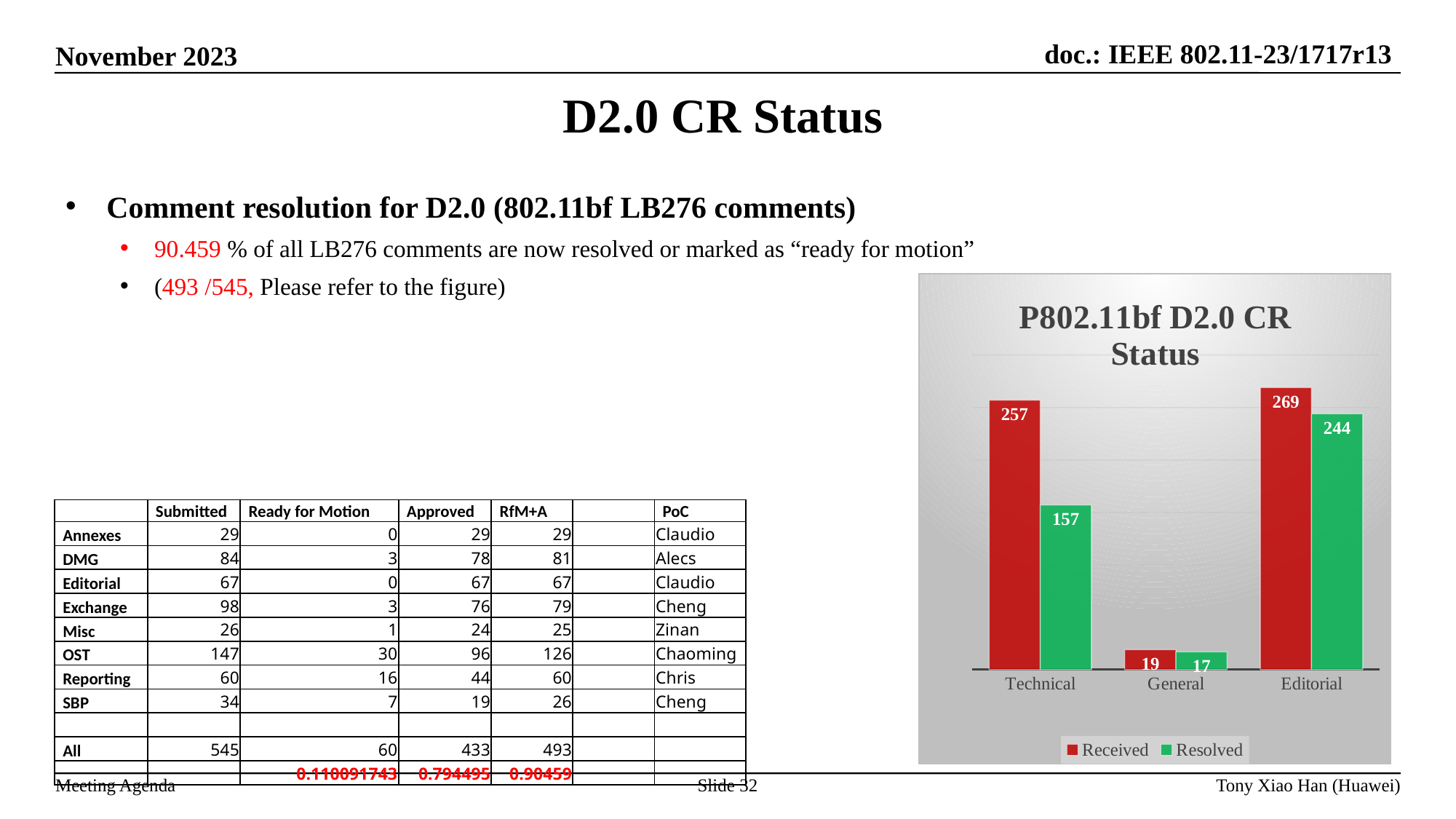
What is the Resolved value for Editorial in the P802.11bf D2.0 CR Status chart? 244 How many categories are shown on the x axis of the P802.11bf D2.0 CR Status chart? 3 Which category has the highest Received value in the P802.11bf D2.0 CR Status chart? Editorial What is the difference between Received and Resolved for Editorial in the P802.11bf D2.0 CR Status chart? 25 What is the difference between Received and Resolved for Technical in the P802.11bf D2.0 CR Status chart? 100 Which colour represents the Resolved series in the P802.11bf D2.0 CR Status chart? green Which category has the lowest Resolved value in the P802.11bf D2.0 CR Status chart? General Is the Resolved value for Technical larger or smaller than the Resolved value for Editorial in the P802.11bf D2.0 CR Status chart? smaller What kind of chart is the P802.11bf D2.0 CR Status chart? bar chart How many series does the legend of the P802.11bf D2.0 CR Status chart list? 2 What is the Resolved value for General in the P802.11bf D2.0 CR Status chart? 17 What is the Received value for Technical in the P802.11bf D2.0 CR Status chart? 257